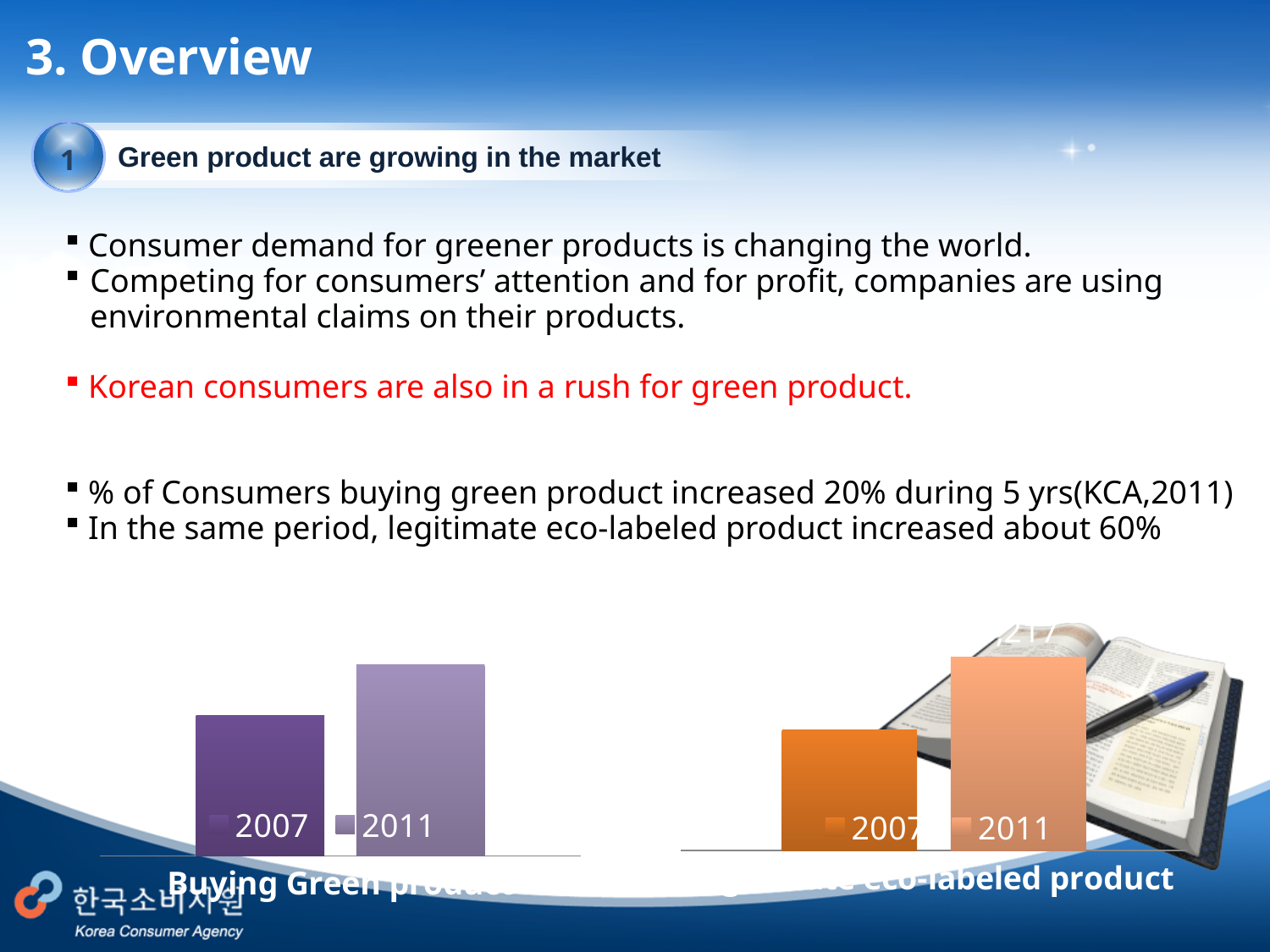
In the right chart with the orange bars, do the values rise or fall from 2007 to 2011? rise What kind of chart is the left chart titled "Buying Green product"? bar chart What colour are the bars in the left chart titled "Buying Green product"? purple How many series does the legend of the left chart titled "Buying Green product" list? 2 How many bars are plotted in the left chart titled "Buying Green product"? 2 In the right chart with the orange bars, which year has the taller bar, 2007 or 2011? 2011 In the right chart with the orange bars, which year has the lowest bar? 2007 In the left chart titled "Buying Green product", which year has the highest bar? 2011 How many series does the legend of the right chart with the orange bars list? 2 In the left chart titled "Buying Green product", which year has the taller bar, 2007 or 2011? 2011 Which years are listed in the legend of the left chart titled "Buying Green product"? 2007 and 2011 What kind of chart is the right chart with the orange bars? bar chart